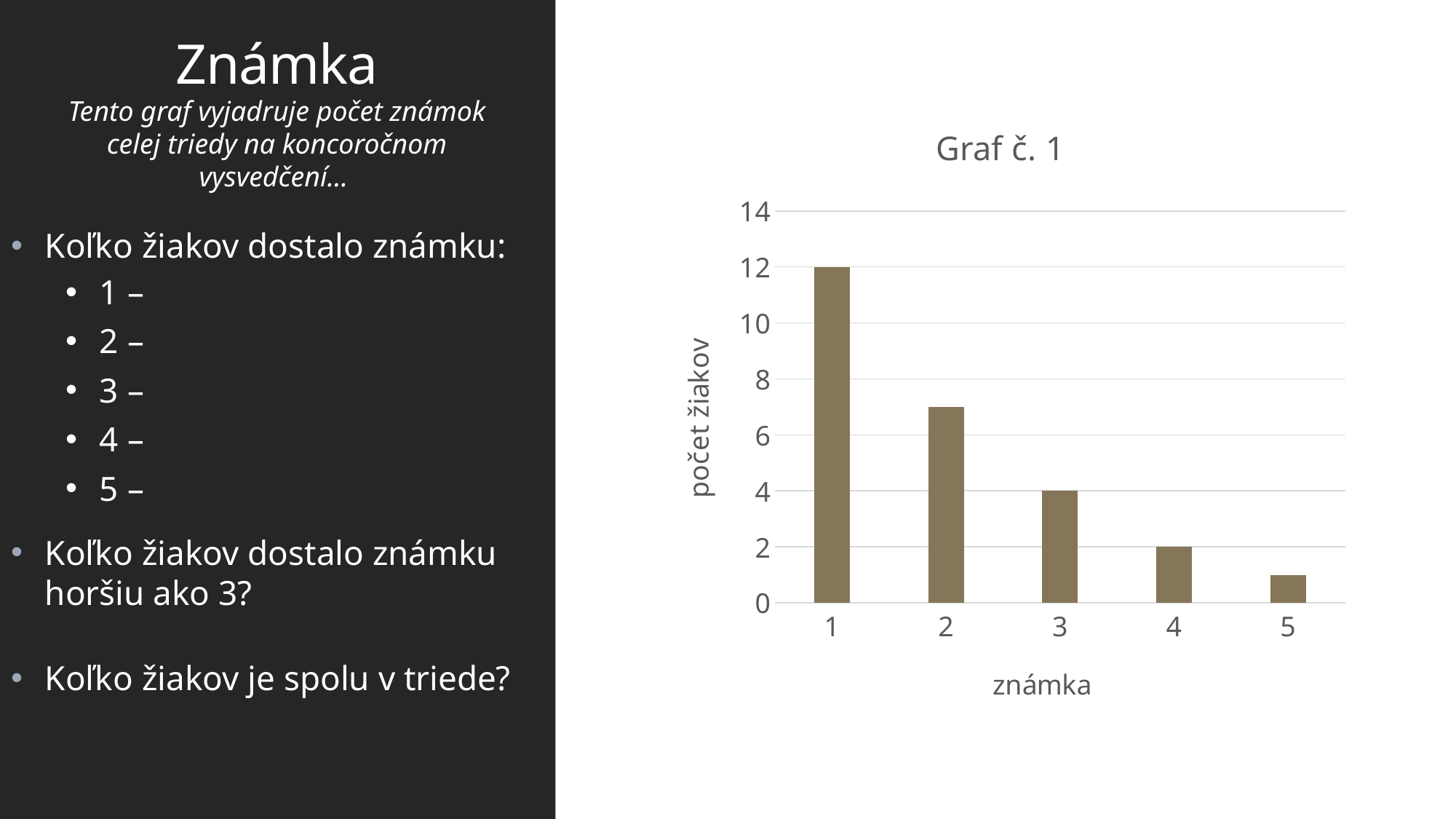
Which is larger, the value for známka 2 or the value for známka 3? známka 2 What is the difference between the values for známka 1 and známka 3? 8 What kind of chart is shown on the slide? bar chart What is the value for známka 3? 4 Which známka has the highest počet žiakov? 1 Is the value for známka 5 greater or less than 2? less What is the value for známka 4? 2 How many categories are shown on the x axis? 5 Do the values rise or fall as známka increases from 1 to 5? fall Which známka has the lowest počet žiakov? 5 What is the value for známka 1? 12 Is the value for známka 2 greater or less than 6? greater